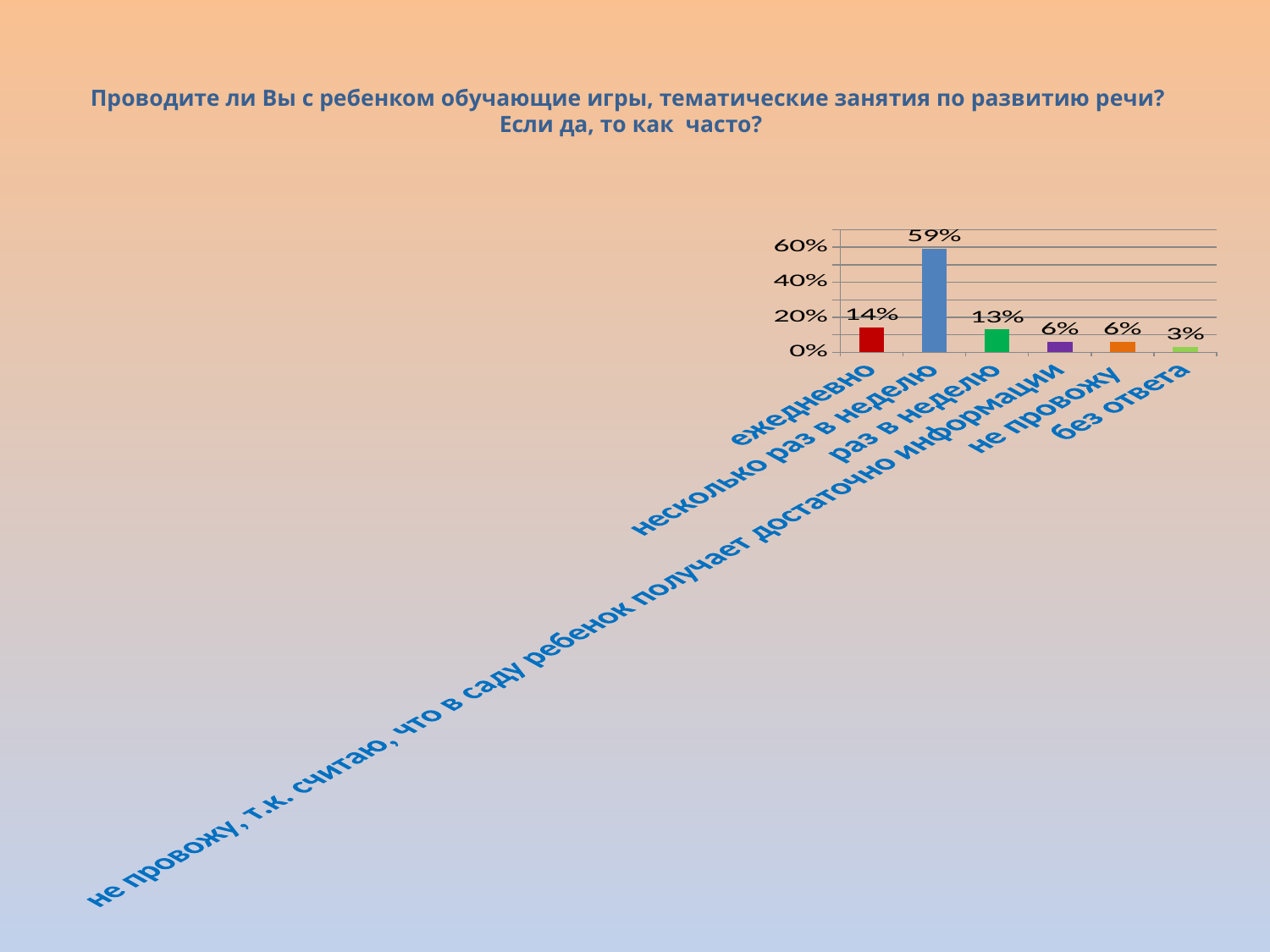
What is the highest tick value shown on the vertical axis? 60% What value is shown for "несколько раз в неделю"? 59% What percentage of respondents answered "ежедневно"? 14% What value is shown for "без ответа"? 3% How many categories are shown on the x axis? 6 Which category has the highest value? несколько раз в неделю What kind of chart is shown on the slide? bar chart What is the difference between the values for "несколько раз в неделю" and "ежедневно"? 45% What percentage is shown for "не провожу"? 6% Which category has the lowest value? без ответа Which is larger, the value for "ежедневно" or the value for "раз в неделю"? ежедневно What percentage is shown for "раз в неделю"? 13%